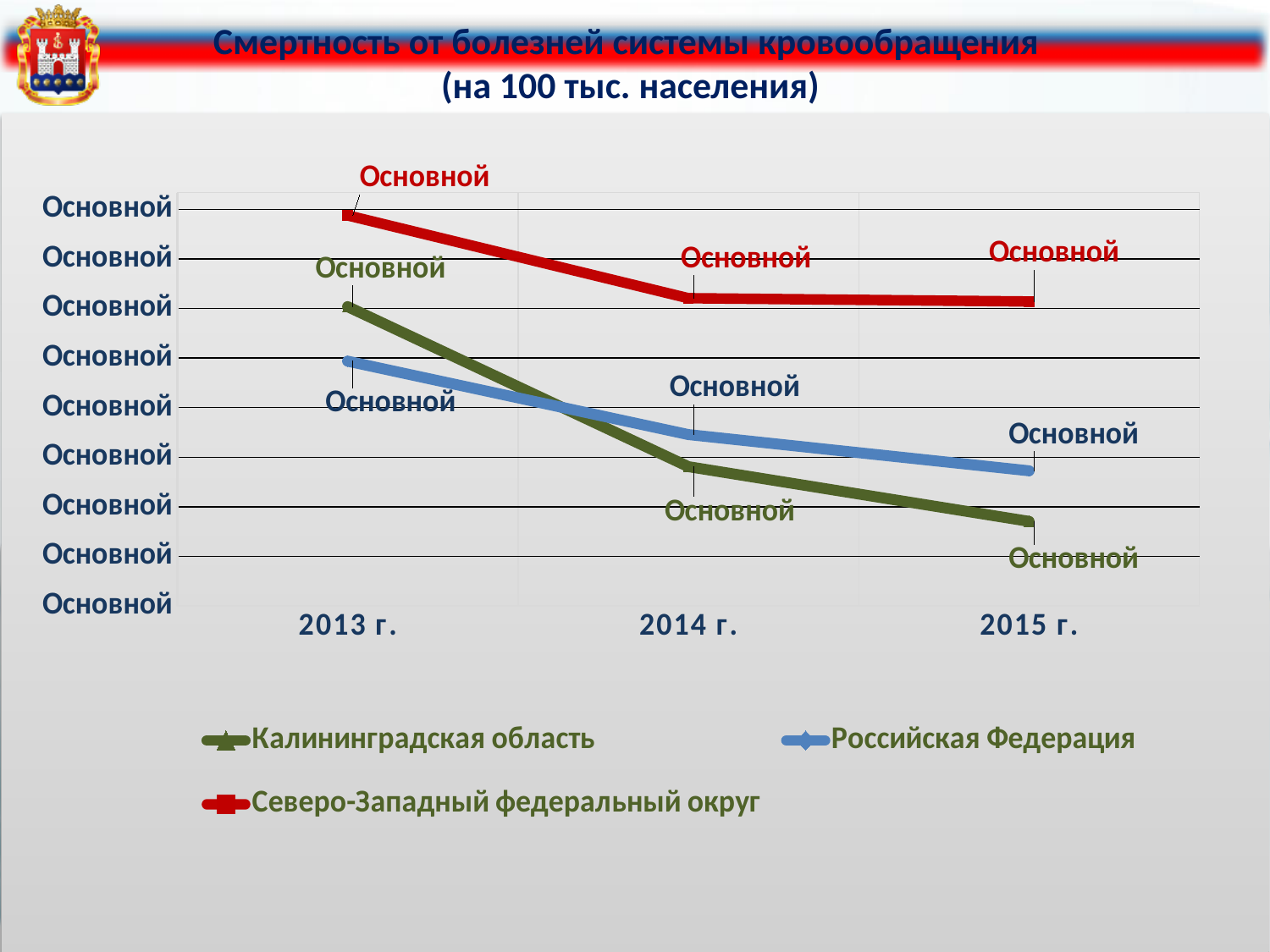
What colour is the line for Северо-Западный федеральный округ? red Which series has the lowest value in 2015 г.? Калининградская область Does the value for Российская Федерация rise or fall from 2013 г. to 2015 г.? fall Does the value for Калининградская область rise or fall from 2013 г. to 2015 г.? fall Which series has the highest value in 2013 г.? Северо-Западный федеральный округ What kind of chart is shown on the slide? line chart In 2014 г., which is larger: the value for Российская Федерация or for Калининградская область? Российская Федерация How many series does the legend list? 3 How many years are shown on the x axis of the chart? 3 What is the title of the chart? Смертность от болезней системы кровообращения (на 100 тыс. населения) Which series has the highest value in 2015 г.? Северо-Западный федеральный округ In 2013 г., which is larger: the value for Калининградская область or for Российская Федерация? Калининградская область